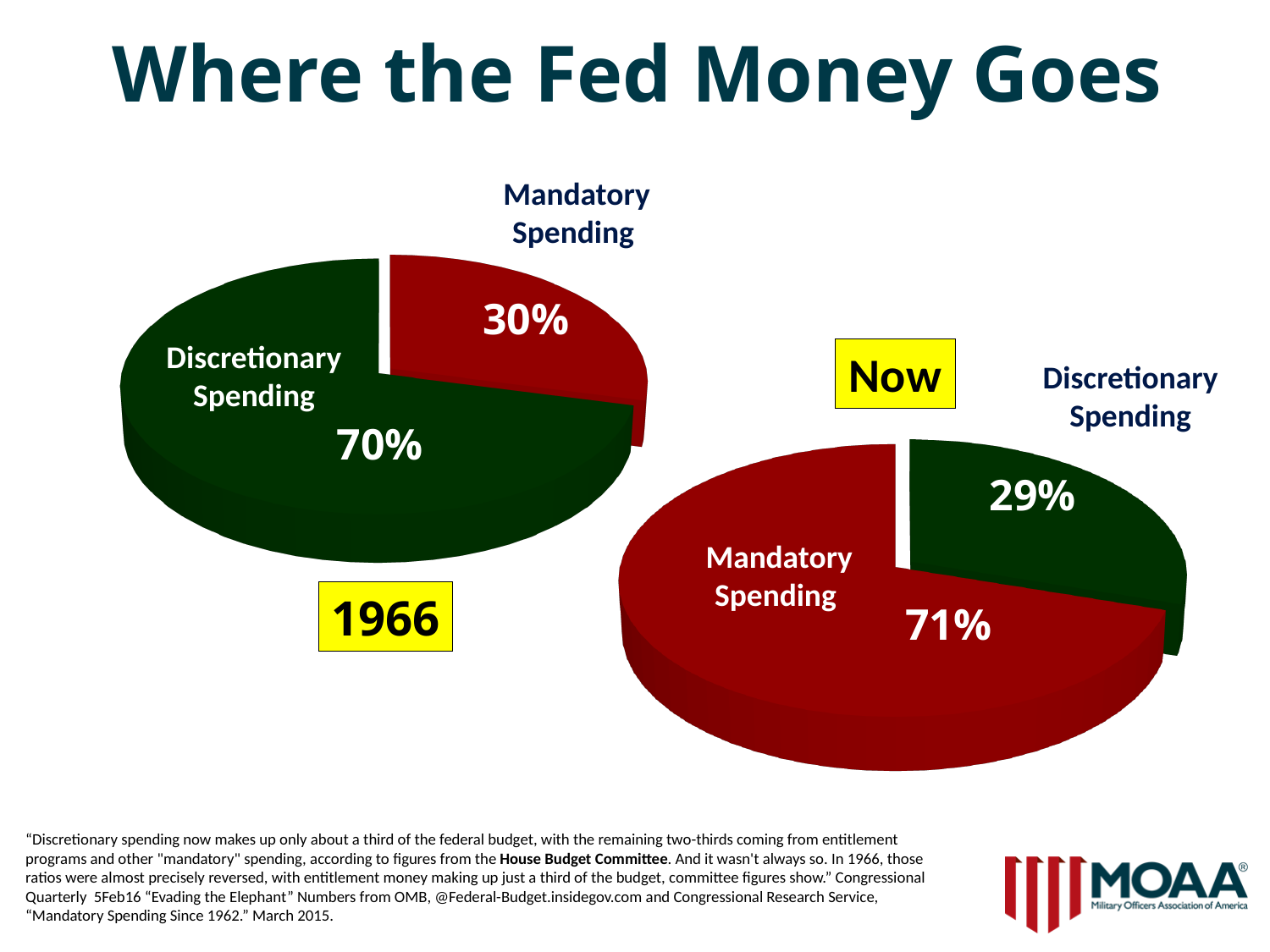
In the Now pie chart, what is the difference between the Mandatory Spending and Discretionary Spending shares? 42% In the Now pie chart, what share is Mandatory Spending? 71% In the 1966 pie chart, what share is Mandatory Spending? 30% How many slices does the 1966 pie chart have? 2 What type of chart is used on this slide? Pie chart In the Now pie chart, what share is Discretionary Spending? 29% In the 1966 pie chart, which category has the largest slice? Discretionary Spending Is Mandatory Spending larger in the 1966 pie chart or in the Now pie chart? Now In the 1966 pie chart, what share is Discretionary Spending? 70% In the Now pie chart, which category has the smallest slice? Discretionary Spending What is the title of the slide? Where the Fed Money Goes In the Now pie chart, what colour is the Mandatory Spending slice? Red